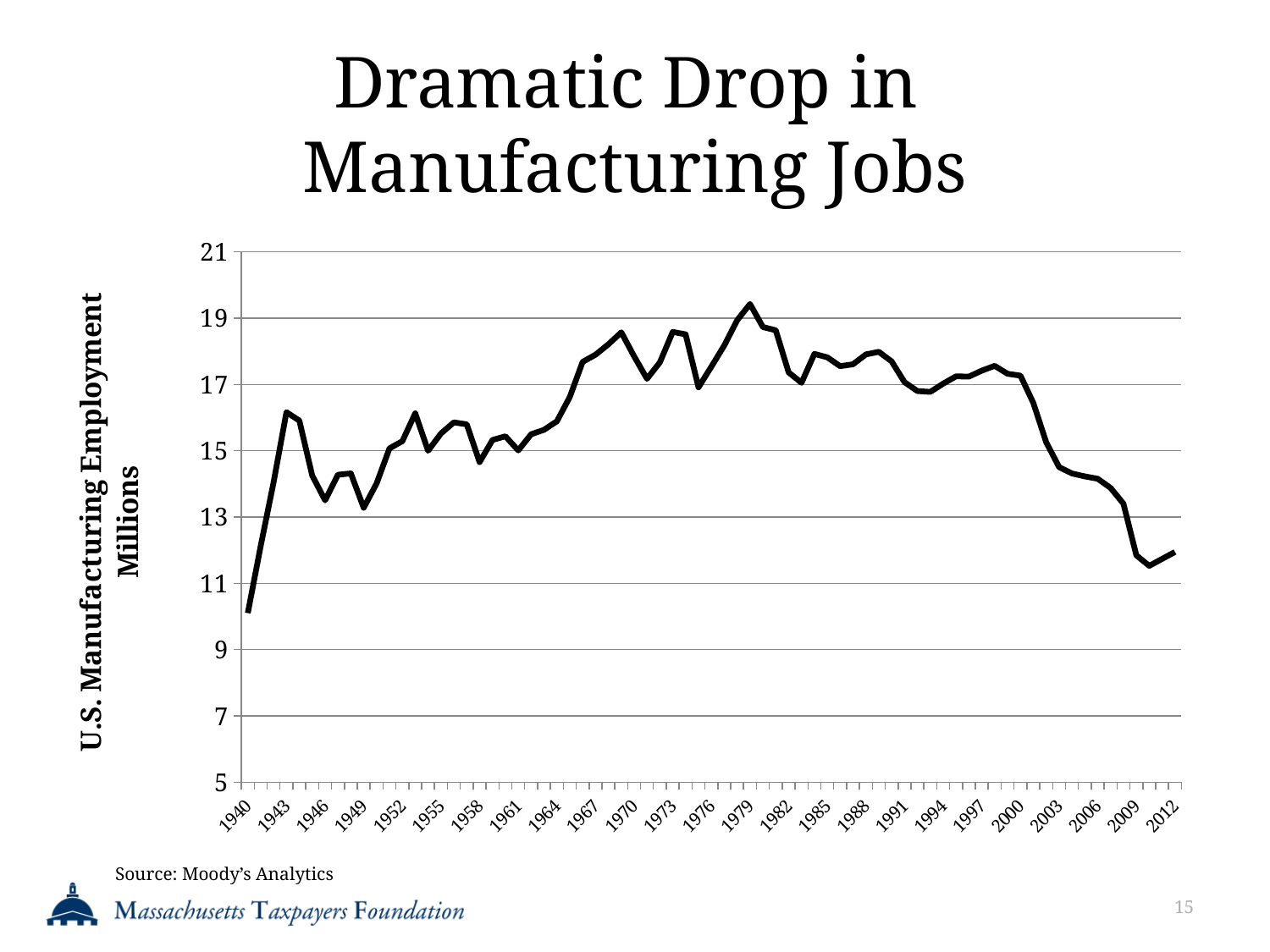
What is the label on the vertical axis of the chart? U.S. Manufacturing Employment Millions Is the value for 1979 greater or less than 19? greater Is the value for 1970 greater or less than 17? greater Is the value for 2003 greater or less than 15? less What kind of chart is shown on the slide? line chart In which year labelled on the x axis is manufacturing employment at its lowest? 1940 Do the values rise or fall between 2000 and 2012? fall What is the title of the chart on the slide? Dramatic Drop in Manufacturing Jobs In which year labelled on the x axis does manufacturing employment reach its highest point? 1979